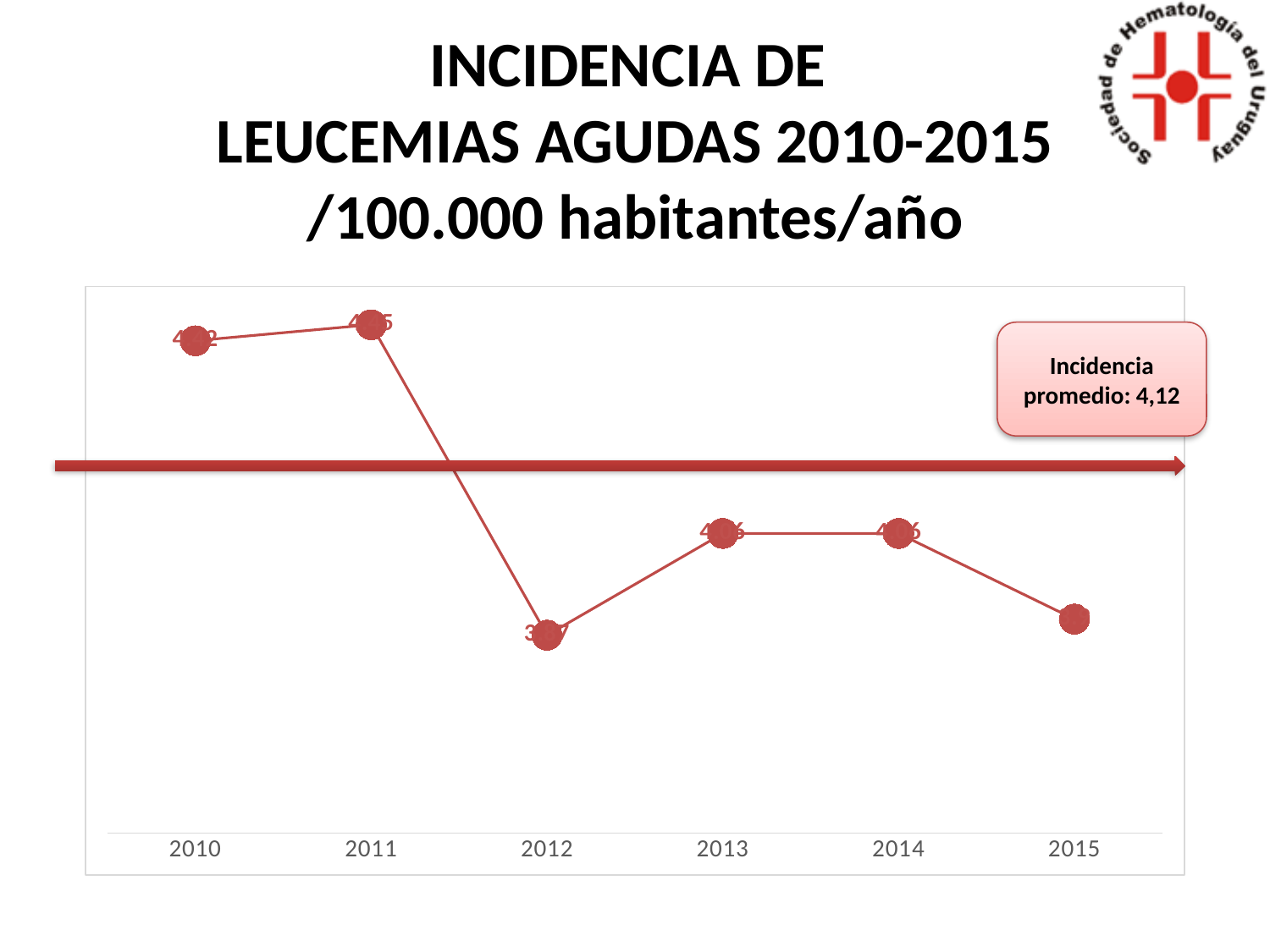
Which year has the highest incidence in the chart? 2011 Which year has the higher incidence, 2011 or 2012? 2011 Does the incidence rise or fall from 2012 to 2013? rise Which year has the lowest incidence in the chart? 2012 What is the first year shown on the x axis of the chart? 2010 What average incidence (incidencia promedio) is stated in the box on the chart? 4,12 Does the incidence rise or fall from 2014 to 2015? fall What kind of chart is shown on the slide? line chart Does the incidence rise or fall from 2011 to 2012? fall Which year has the higher incidence, 2010 or 2015? 2010 How many years are plotted on the x axis of the chart? 6 Which year has the higher incidence, 2012 or 2015? 2015